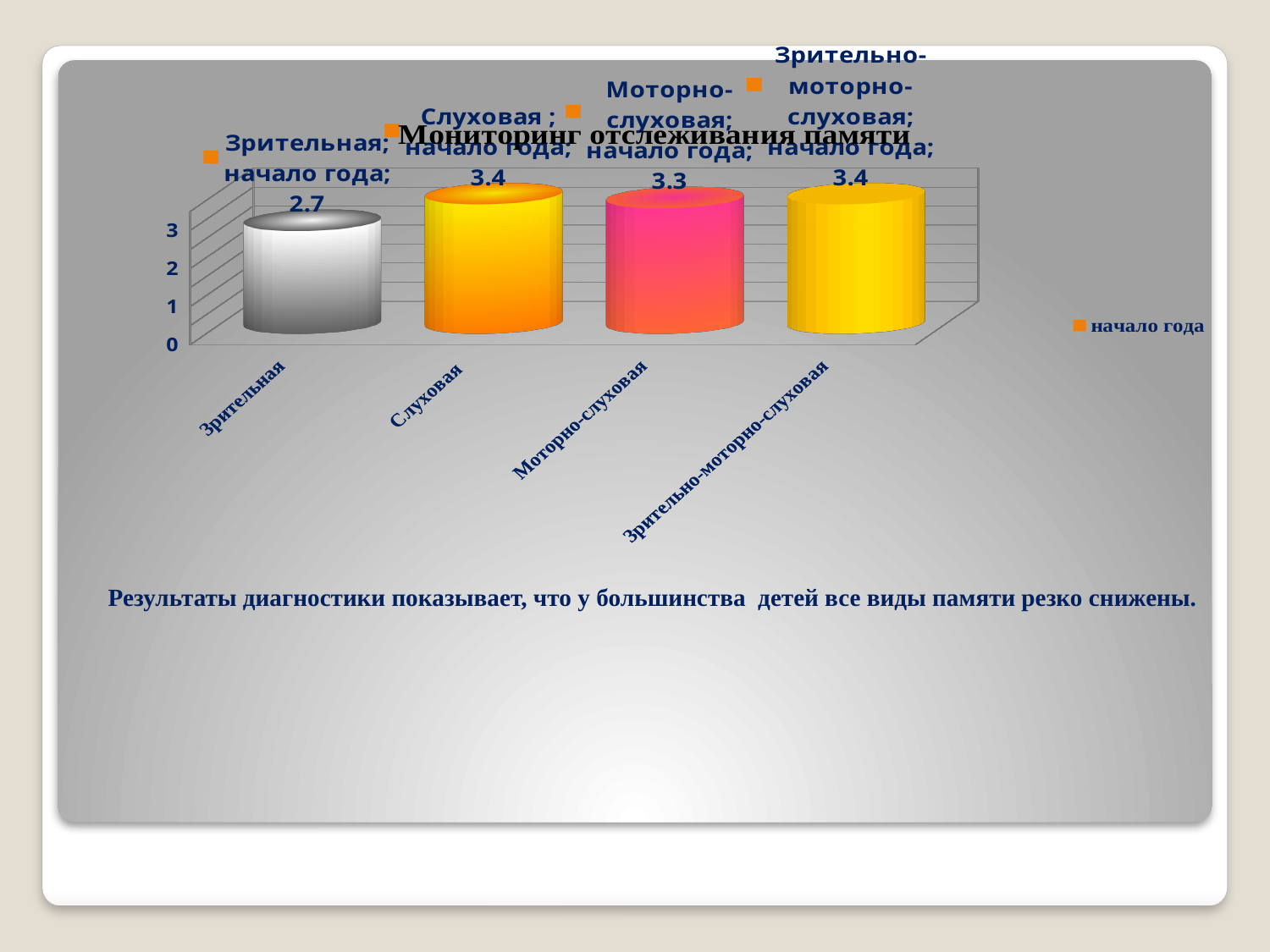
What is the value for Зрительная? 2.7 Which is larger, the value for Моторно-слуховая or the value for Зрительная? Моторно-слуховая What is the value for Слуховая? 3.4 What is the difference between the values for Моторно-слуховая and Зрительная? 0.6 What is the difference between the values for Слуховая and Зрительная? 0.7 Is the value for Зрительная greater or less than 3? less How many categories are shown in the chart? 4 What is the value for Моторно-слуховая? 3.3 Which category has the lowest value? Зрительная How many series does the legend list? 1 What is the value for Зрительно-моторно-слуховая? 3.4 What is the title of the chart? Мониторинг отслеживания памяти